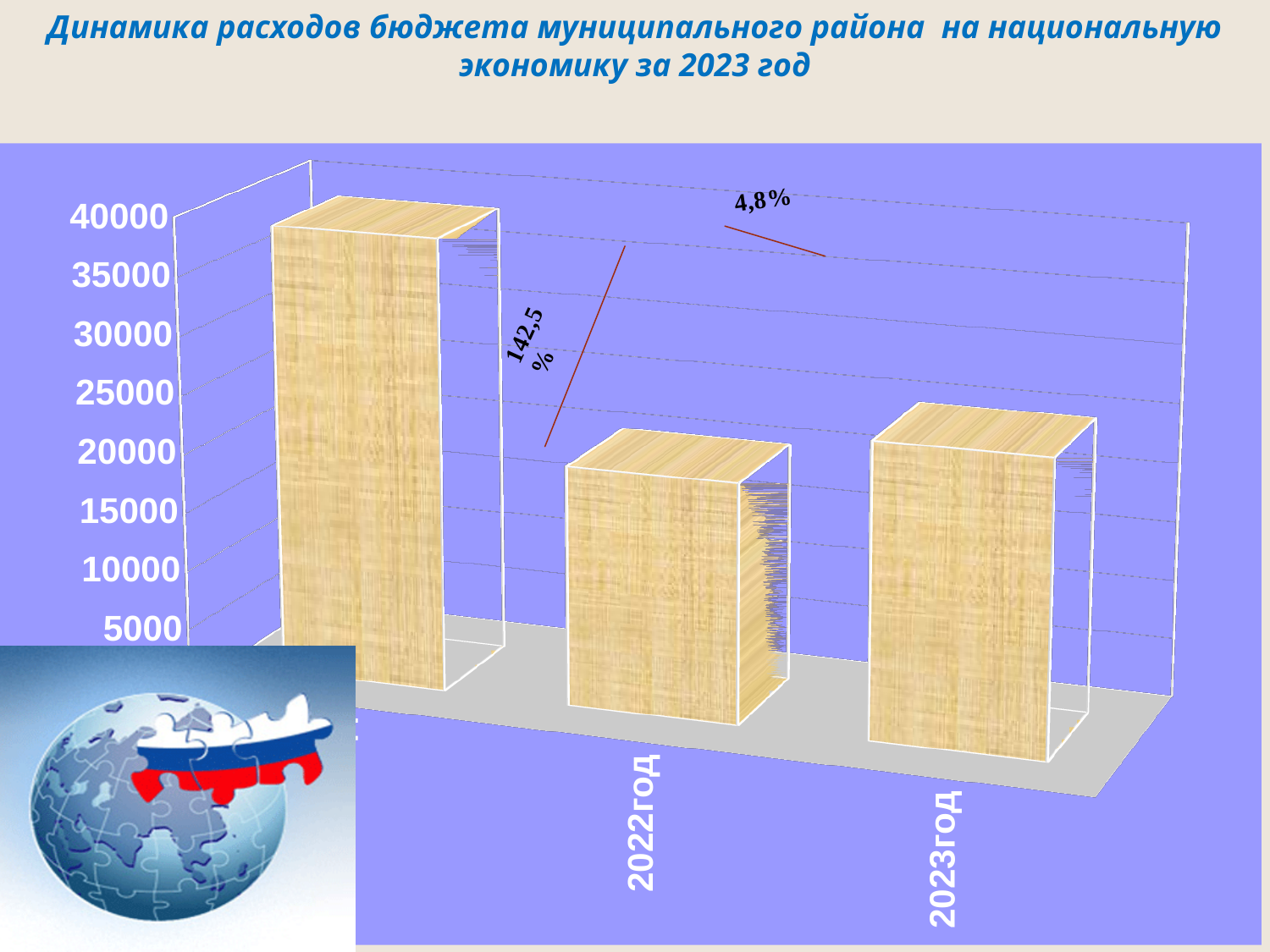
Does the value rise or fall from 2022год to 2023год? rise What percentage annotation is written near the top of the chart between the 2022 and 2023 bars? 4,8% Is the value for 2023год greater or less than 15000? greater Which is larger, the value for 2022год or the value for 2023год? 2023год Is the value for 2022год greater or less than 10000? greater Which year has the lowest bar in the chart? 2022год What kind of chart is shown on the slide? bar chart How many bars are plotted in the chart? 3 What is the highest tick value shown on the vertical axis? 40000 Is the value for 2023год greater or less than 30000? less